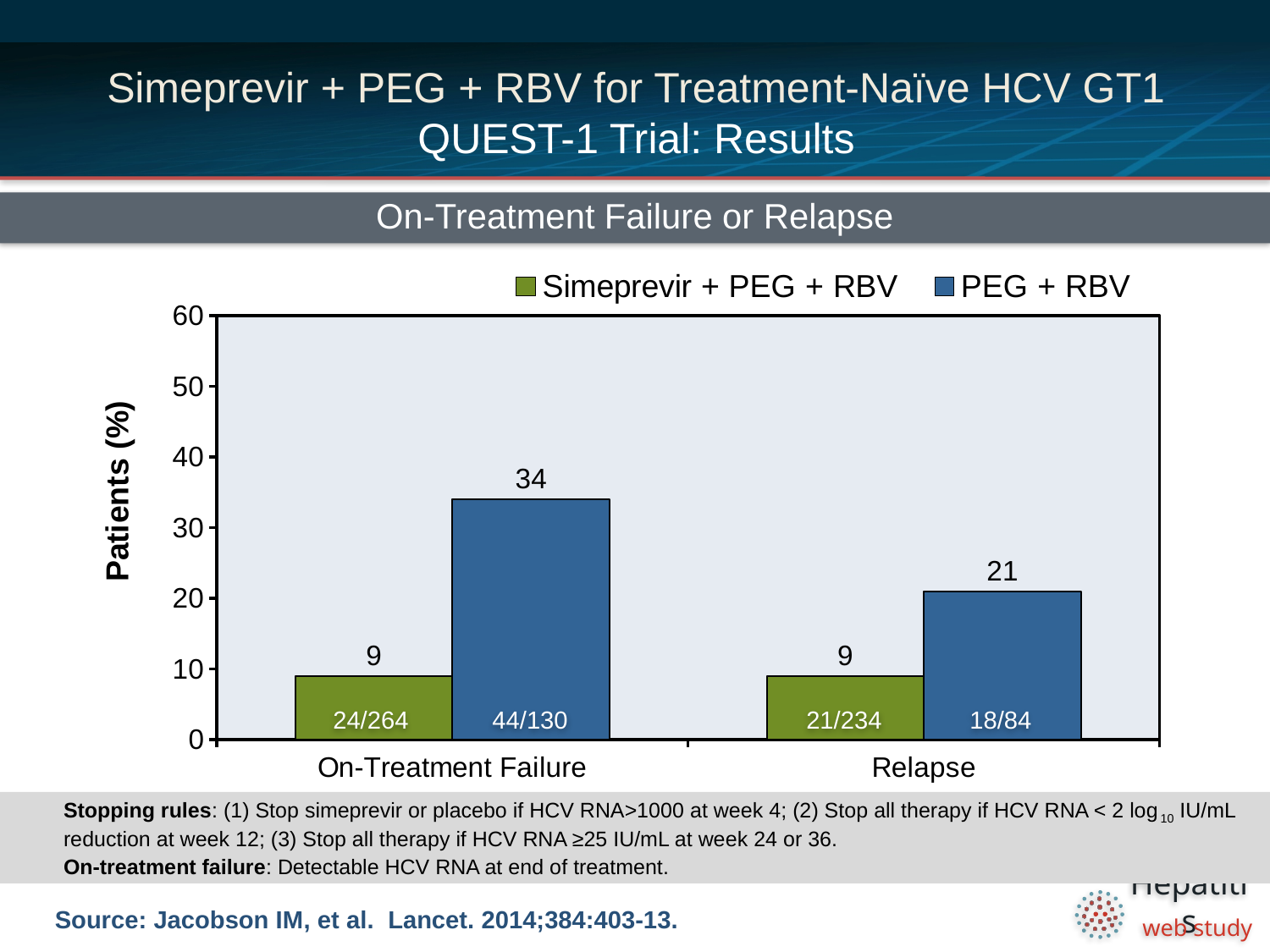
What is the difference between the PEG + RBV and Simeprevir + PEG + RBV values for Relapse? 12 Is the PEG + RBV value for On-Treatment Failure greater or less than 30? greater What is the difference between the PEG + RBV and Simeprevir + PEG + RBV values for On-Treatment Failure? 25 What is the value for Simeprevir + PEG + RBV in the On-Treatment Failure category? 9 How many series does the legend list? 2 What fraction is printed inside the PEG + RBV bar for Relapse? 18/84 Which series has the highest value in the On-Treatment Failure category? PEG + RBV What kind of chart is shown on the slide? bar chart What is the value for PEG + RBV in the On-Treatment Failure category? 34 What is the value for PEG + RBV in the Relapse category? 21 What is the label of the y axis? Patients (%) How many categories are shown on the x axis? 2